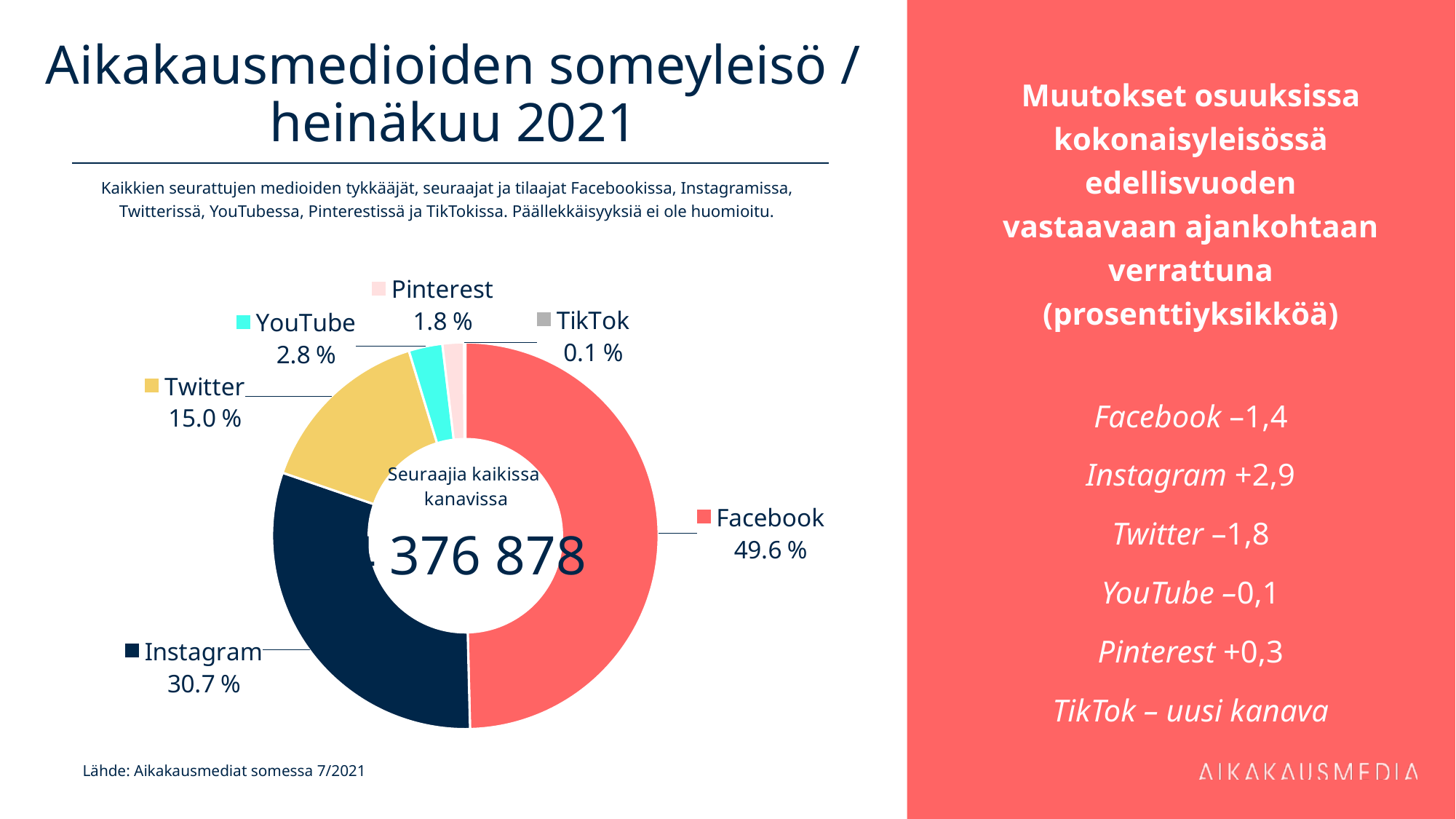
What is the difference in percentage points between Facebook and Instagram? 18.9 What share of the pie does Facebook have? 49.6 % What kind of chart is shown on the slide? Pie chart (donut) What is the value shown for Twitter? 15.0 % What colour is the Twitter slice in the chart? Yellow How many categories are shown in the chart? 6 What is the value shown for Instagram? 30.7 % Which category has the largest share of the chart? Facebook What is the value shown for Pinterest? 1.8 % Which category has the smallest share of the chart? TikTok Which is larger, the share for Twitter or the share for YouTube? Twitter What is the value shown for YouTube? 2.8 %